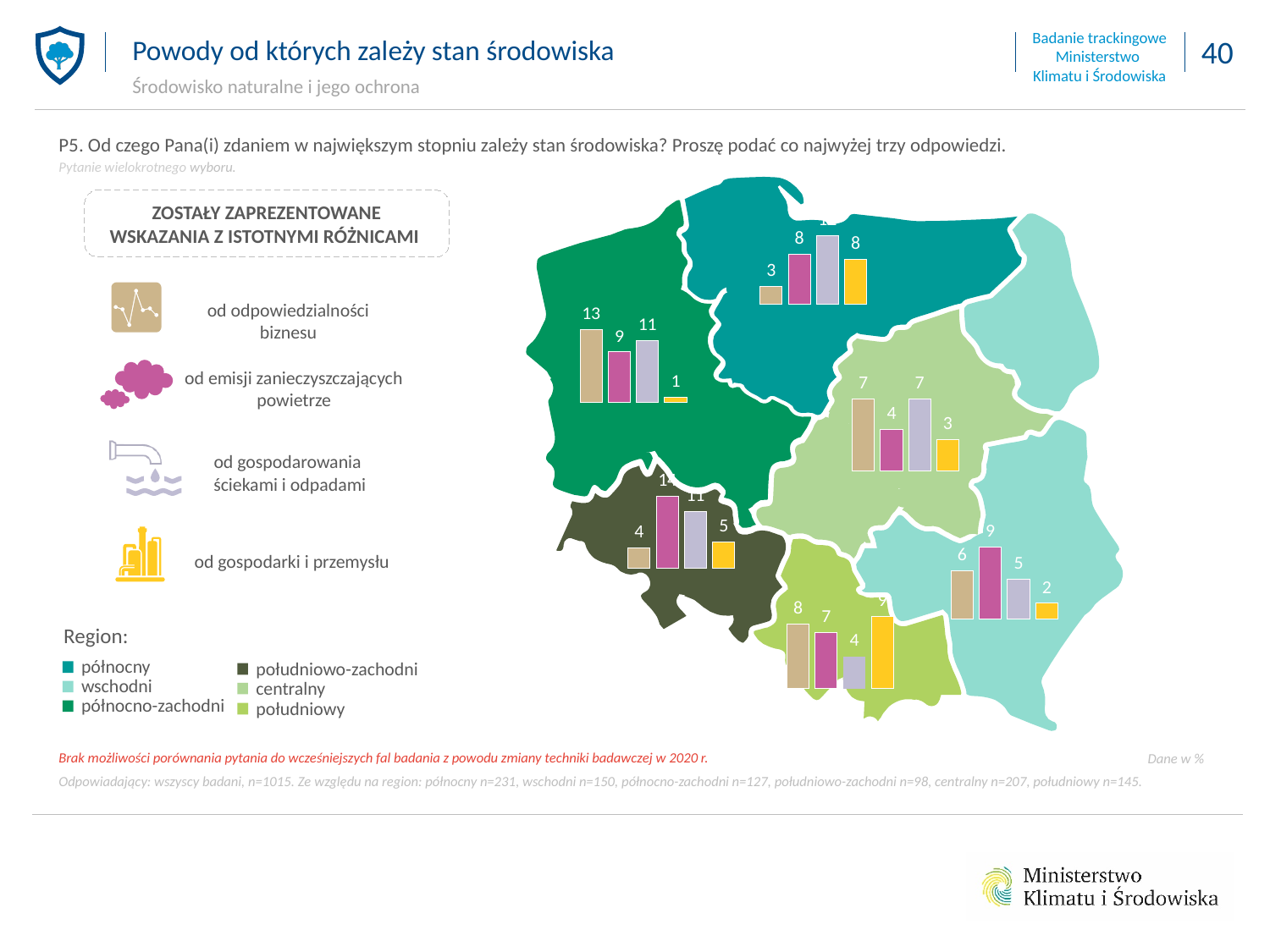
In the chart for the północno-zachodni region, what is the value for 'od odpowiedzialności biznesu'? 13 In the chart for the północny region, what is the value for 'od odpowiedzialności biznesu'? 3 What type of chart is used for each region on the map? bar chart In the chart for the północno-zachodni region, which answer has the lowest value? od gospodarki i przemysłu In the chart for the centralny region, what is the value for 'od gospodarki i przemysłu'? 3 In the chart for the północno-zachodni region, what is the difference between 'od odpowiedzialności biznesu' and 'od emisji zanieczyszczających powietrze'? 4 In the chart for the wschodni region, which answer has the highest value? od emisji zanieczyszczających powietrze In the chart for the północno-zachodni region, what is the value for 'od gospodarki i przemysłu'? 1 In the chart for the wschodni region, what is the value for 'od emisji zanieczyszczających powietrze'? 9 How many regions are listed in the 'Region' legend? 6 How many answer categories (series) are shown in each regional chart? 4 In the chart for the południowy region, which is larger: 'od odpowiedzialności biznesu' or 'od gospodarowania ściekami i odpadami'? od odpowiedzialności biznesu